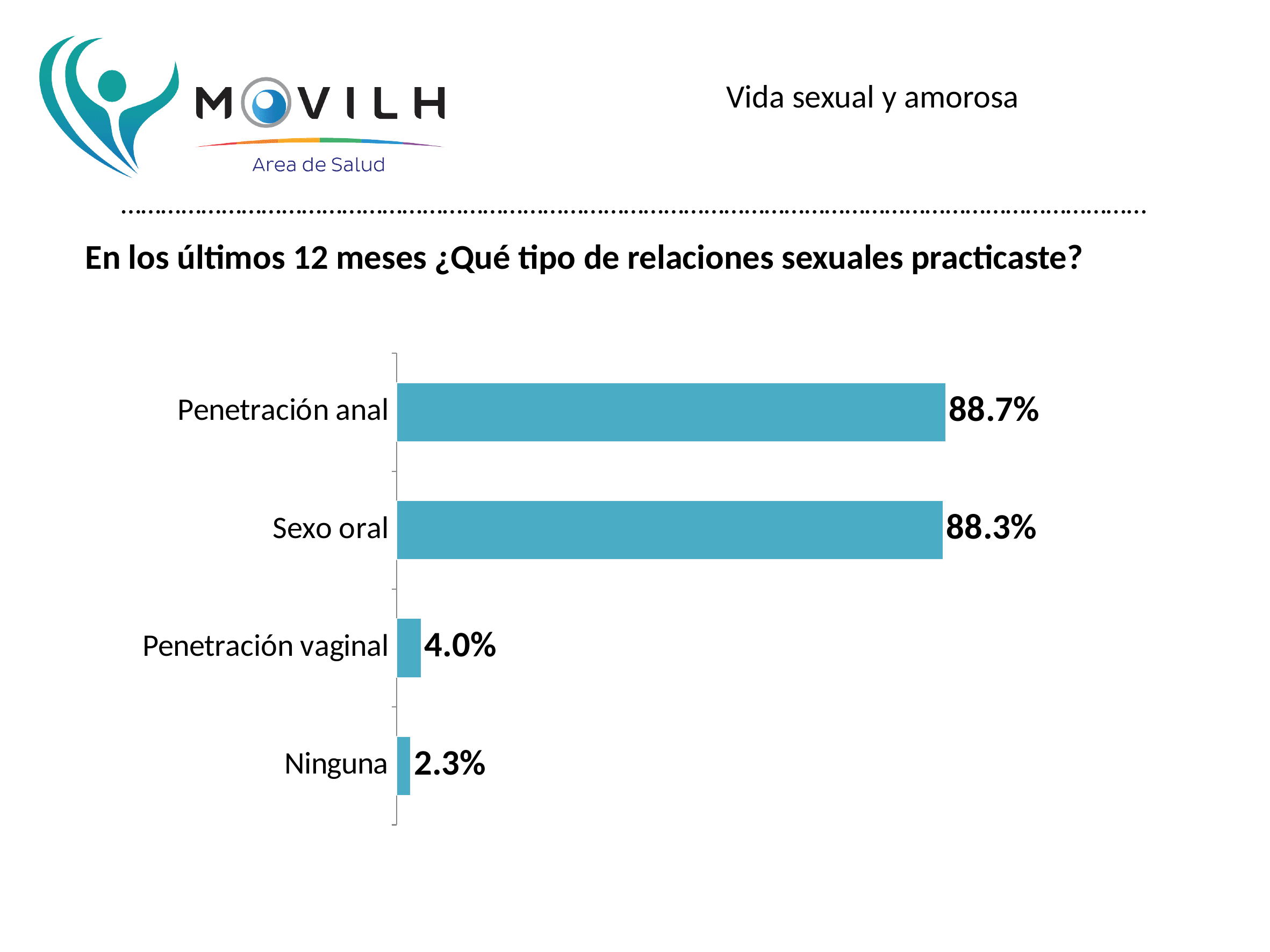
What is the difference in percentage points between Penetración anal and Sexo oral? 0.4 What percentage is shown for Sexo oral? 88.3% What kind of chart is shown on the slide? Bar chart What percentage is shown for Ninguna? 2.3% How many categories are shown in the chart? 4 Which category has the highest percentage? Penetración anal What question does the chart title ask? En los últimos 12 meses ¿Qué tipo de relaciones sexuales practicaste? What percentage is shown for Penetración anal? 88.7% Which is larger, the value for Penetración vaginal or the value for Ninguna? Penetración vaginal Which category has the lowest percentage? Ninguna What percentage is shown for Penetración vaginal? 4.0% What is the difference in percentage points between Penetración vaginal and Ninguna? 1.7